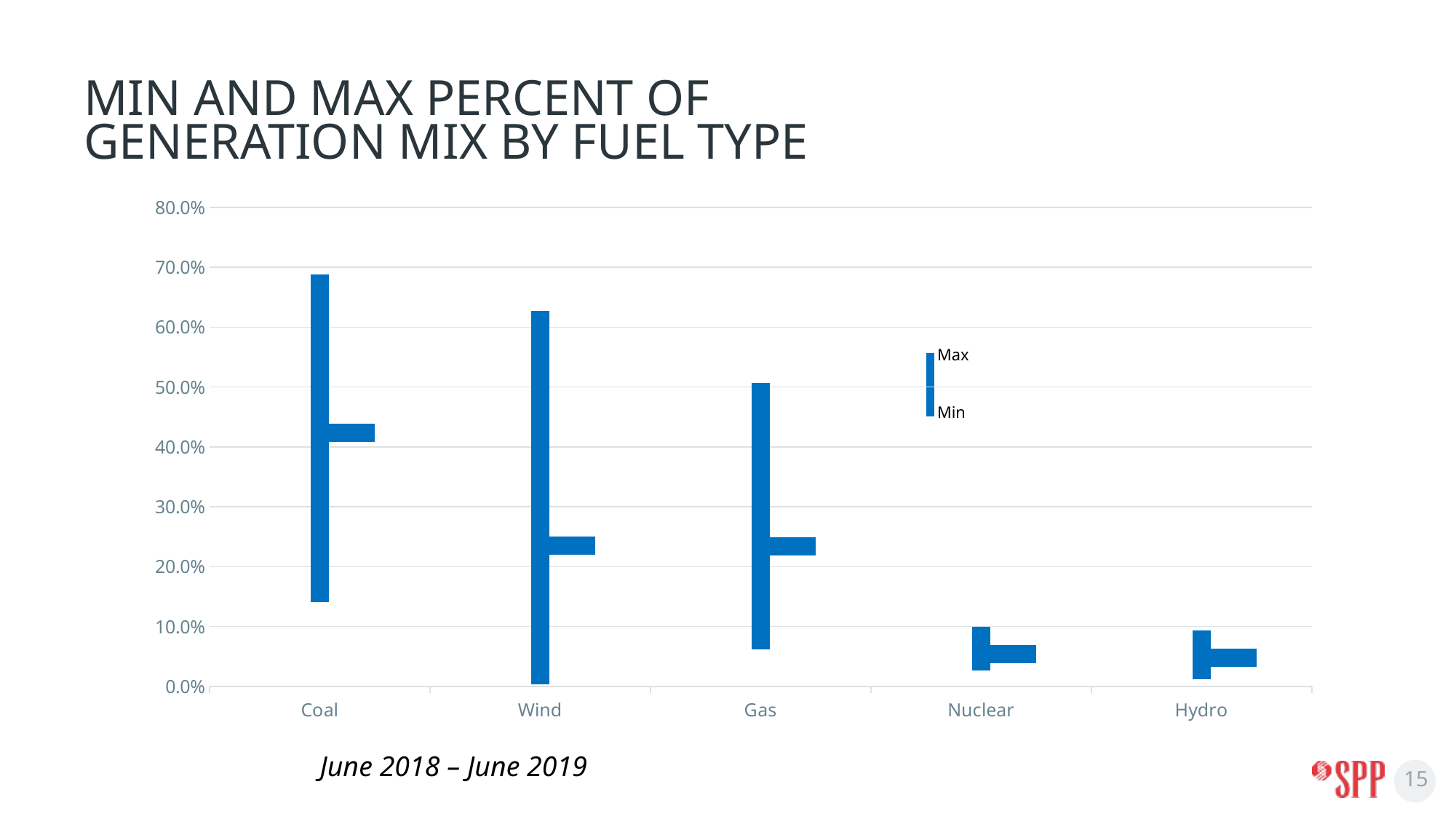
Is the maximum value for Nuclear greater or less than 20.0%? less How many fuel types are shown on the x axis? 5 Which fuel type has the lowest minimum percent of generation mix? Wind Which has a larger minimum value, Coal or Gas? Coal Is the maximum value for Gas greater or less than 40.0%? greater Which fuel type has the highest maximum percent of generation mix? Coal What time period does the chart cover, according to the note below it? June 2018 – June 2019 Is the minimum value for Wind greater or less than 10.0%? less What kind of chart is shown on the slide? bar chart Which has a larger maximum value, Coal or Wind? Coal What two labels does the chart's legend show? Max and Min